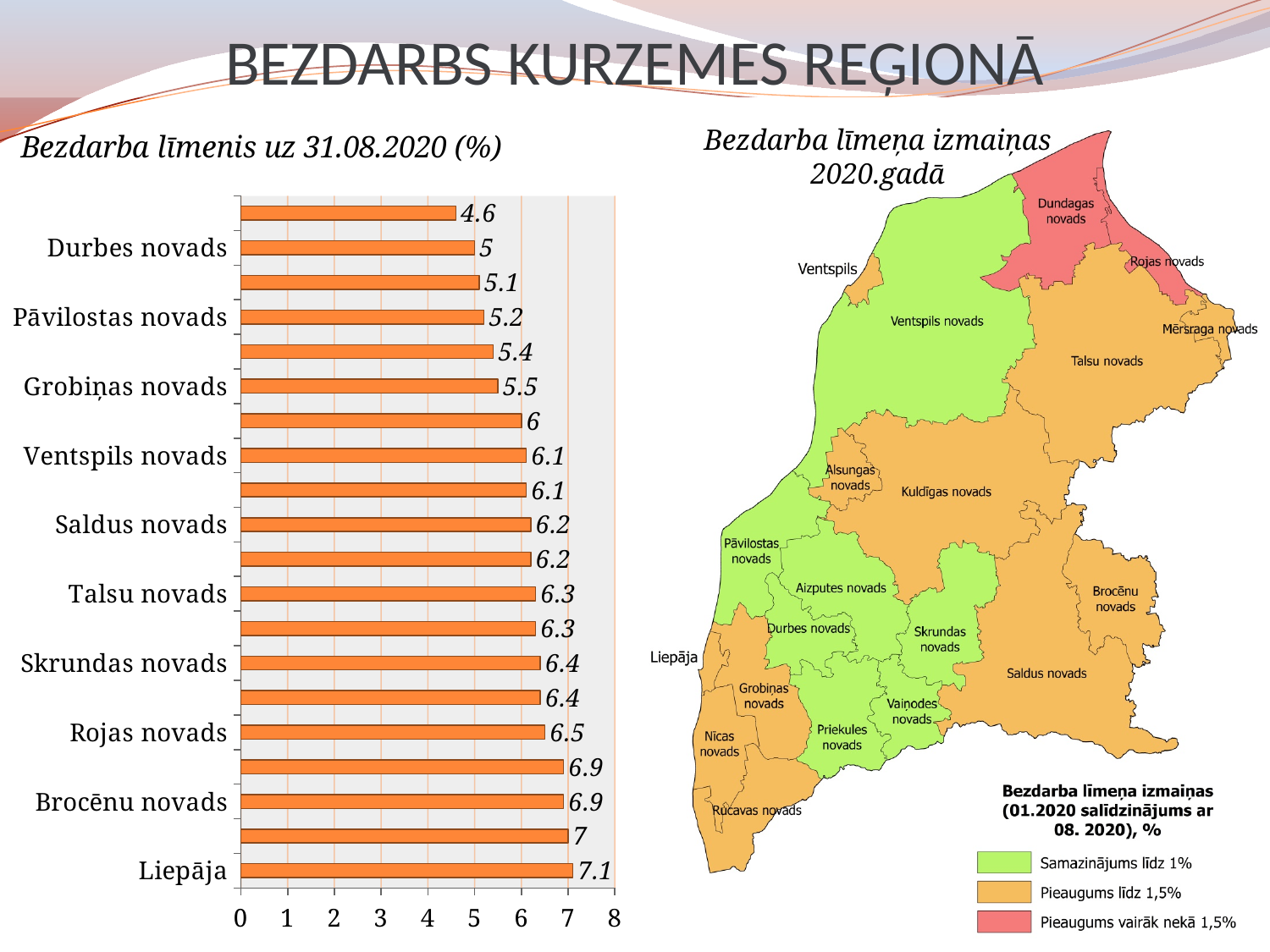
In the bar chart, which is larger: the value for Talsu novads or the value for Pāvilostas novads? Talsu novads In the bar chart, what is the difference between the values for Liepāja and Durbes novads? 2.1 What is the lowest value shown in the bar chart? 4.6 In the bar chart, what is the unemployment rate for Liepāja? 7.1 In the bar chart, what is the value for Brocēnu novads? 6.9 What kind of chart is used to show the unemployment rate (Bezdarba līmenis uz 31.08.2020)? bar chart In the bar chart, what is the value for Grobiņas novads? 5.5 How many bars are plotted in the bar chart? 20 In the bar chart, what is the value for Rojas novads? 6.5 In the bar chart, what is the unemployment rate for Durbes novads? 5 Which labelled category has the highest value in the bar chart? Liepāja What is the title of the bar chart on the left of the slide? Bezdarba līmenis uz 31.08.2020 (%)